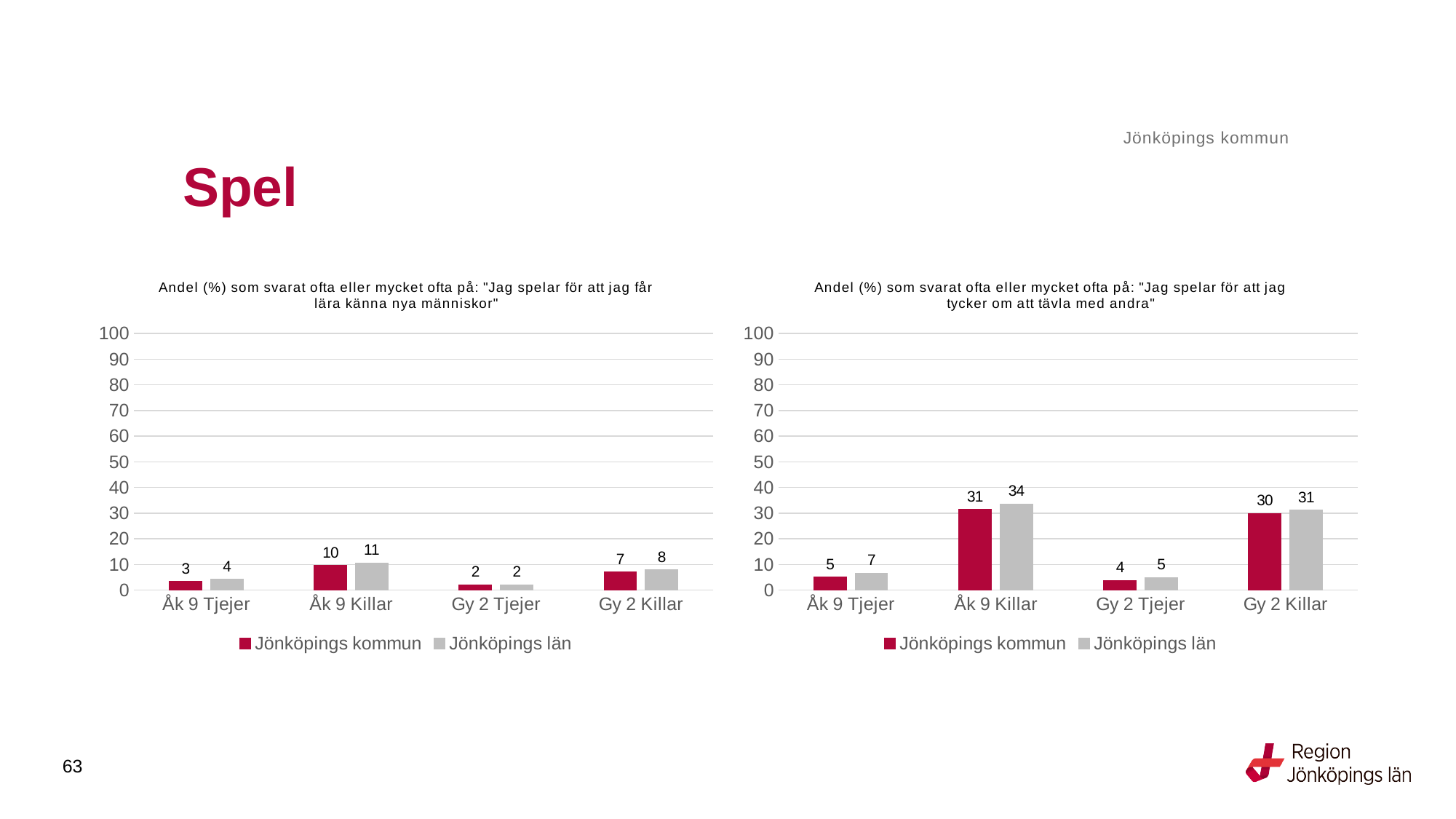
In the right chart ("Jag spelar för att jag tycker om att tävla med andra"), is the value for Jönköpings kommun for Gy 2 Killar greater or less than 20? greater In the left chart ("Jag spelar för att jag får lära känna nya människor"), what is the value for Jönköpings kommun for Åk 9 Killar? 10 How many series does the legend of the right chart ("Jag spelar för att jag tycker om att tävla med andra") list? 2 In the right chart ("Jag spelar för att jag tycker om att tävla med andra"), what is the value for Jönköpings kommun for Gy 2 Tjejer? 4 In the left chart ("Jag spelar för att jag får lära känna nya människor"), which is larger for Gy 2 Killar: Jönköpings kommun or Jönköpings län? Jönköpings län In the right chart ("Jag spelar för att jag tycker om att tävla med andra"), which category has the highest value for Jönköpings kommun? Åk 9 Killar In the right chart ("Jag spelar för att jag tycker om att tävla med andra"), what is the difference between Jönköpings län and Jönköpings kommun for Åk 9 Killar? 3 In the left chart ("Jag spelar för att jag får lära känna nya människor"), which category has the lowest value for Jönköpings län? Gy 2 Tjejer What kind of chart is the left chart ("Jag spelar för att jag får lära känna nya människor")? Bar chart In the left chart ("Jag spelar för att jag får lära känna nya människor"), what is the value for Jönköpings län for Gy 2 Killar? 8 How many categories are shown on the x axis of the left chart ("Jag spelar för att jag får lära känna nya människor")? 4 In the right chart ("Jag spelar för att jag tycker om att tävla med andra"), what is the value for Jönköpings län for Åk 9 Killar? 34